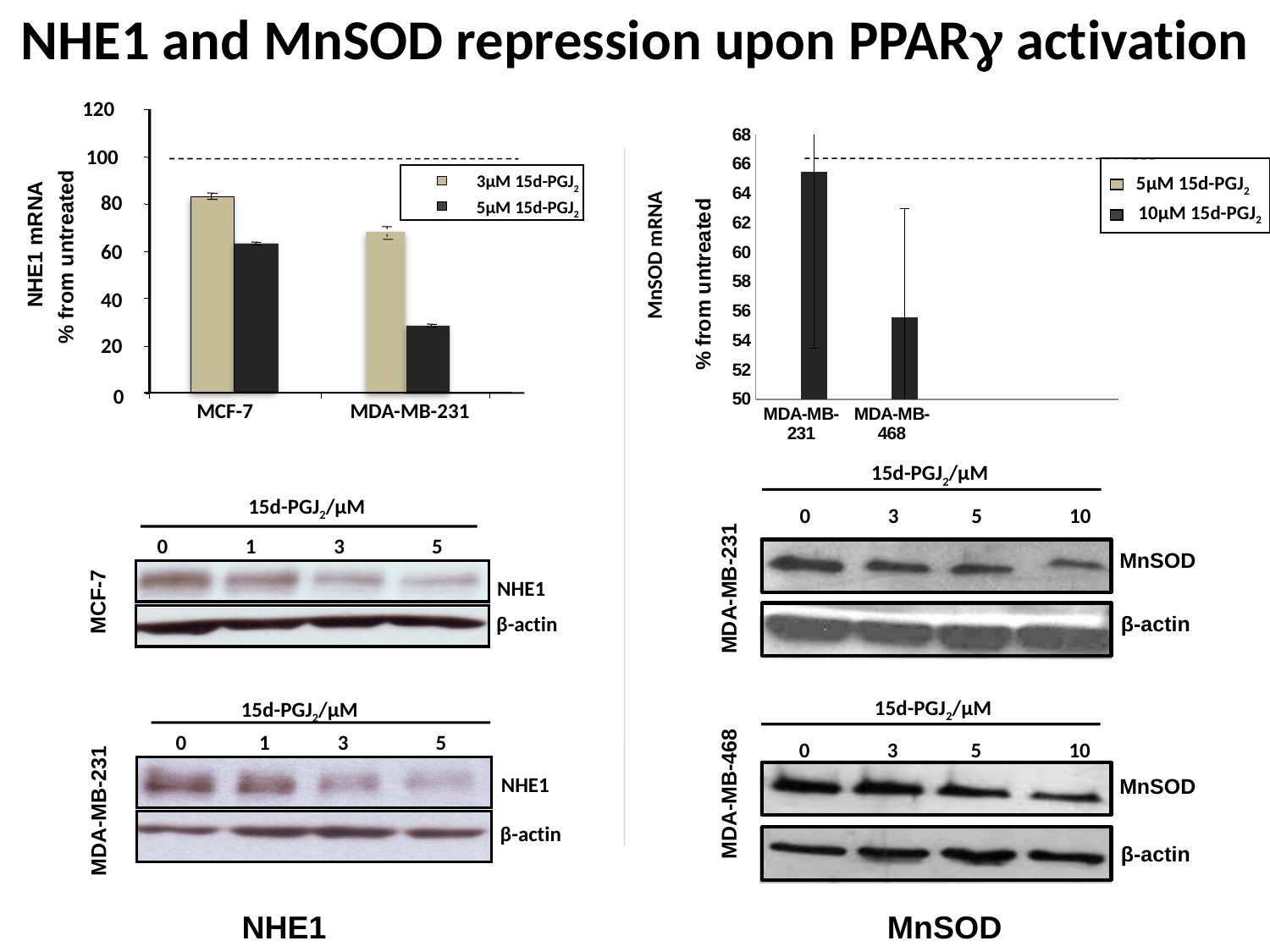
In the MnSOD mRNA chart on the right, is the value for MDA-MB-468 greater or less than 60? less In the NHE1 mRNA chart on the left, how many series does the legend list? 2 In the MnSOD mRNA chart on the right, how many series does the legend list? 2 In the NHE1 mRNA chart on the left, for MCF-7, which treatment gives the larger value: 3µM or 5µM 15d-PGJ2? 3µM 15d-PGJ2 In the MnSOD mRNA chart on the right, which cell line has the higher bar: MDA-MB-231 or MDA-MB-468? MDA-MB-231 In the NHE1 mRNA chart on the left, which is larger at 5µM 15d-PGJ2: MCF-7 or MDA-MB-231? MCF-7 In the NHE1 mRNA chart on the left, how many cell lines are shown on the x axis? 2 In the NHE1 mRNA chart on the left, is the value for MDA-MB-231 at 5µM 15d-PGJ2 greater or less than 40? less In the MnSOD mRNA chart on the right, is the value for MDA-MB-231 greater or less than 60? greater In the NHE1 mRNA chart on the left, what kind of chart is used? bar chart